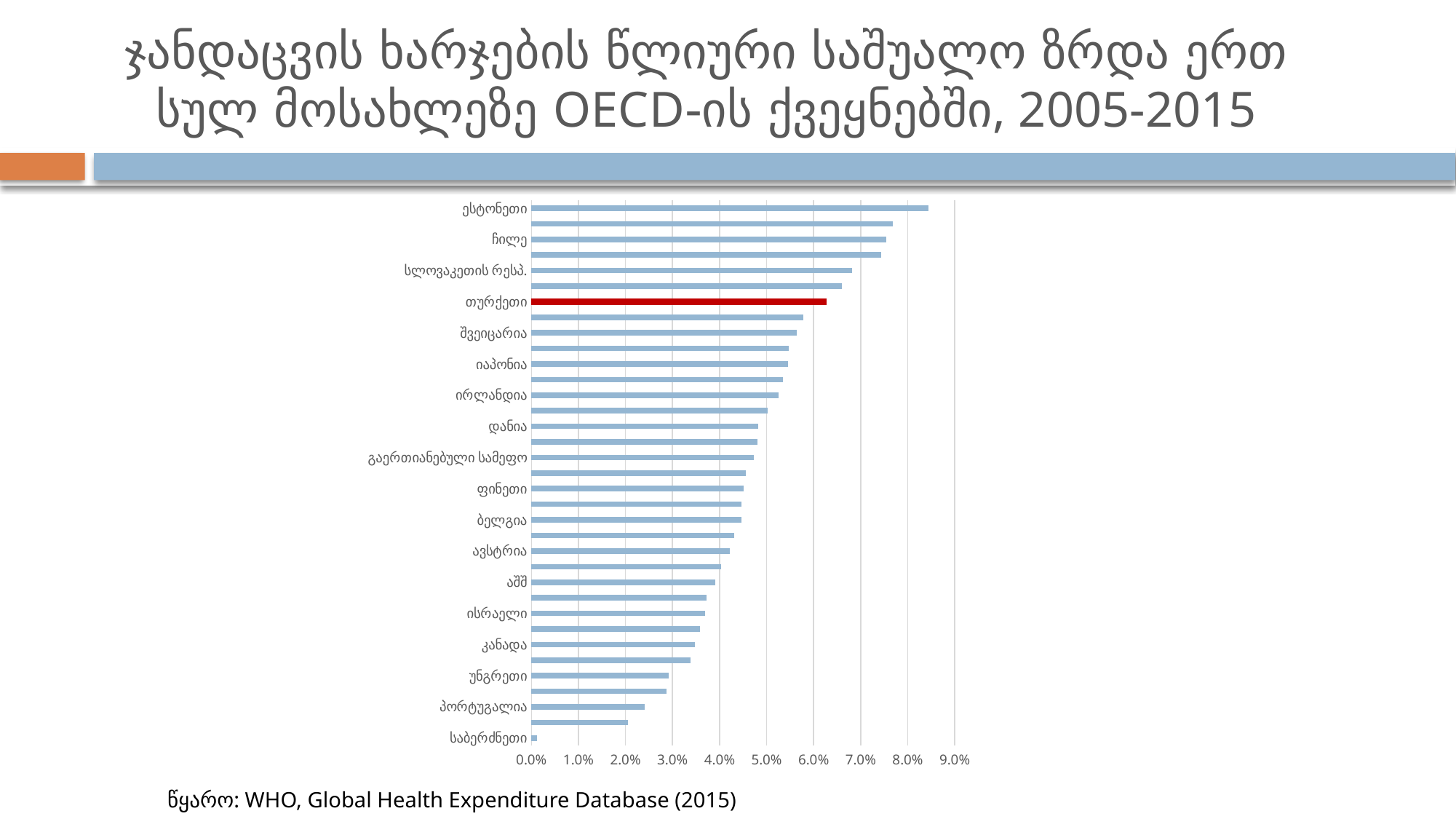
Is the value for ესტონეთი greater or less than 8.0%? greater Which country has the lowest value in the chart? საბერძნეთი Is the value for პორტუგალია greater or less than 3.0%? less Which has the larger value, ჩილე or თურქეთი? ჩილე Is the value for თურქეთი greater or less than 6.0%? greater Which country's bar is highlighted in red? თურქეთი Do the bar values increase or decrease going from the top of the chart to the bottom? decrease Which country has the highest value in the chart? ესტონეთი What kind of chart is shown on the slide? bar chart